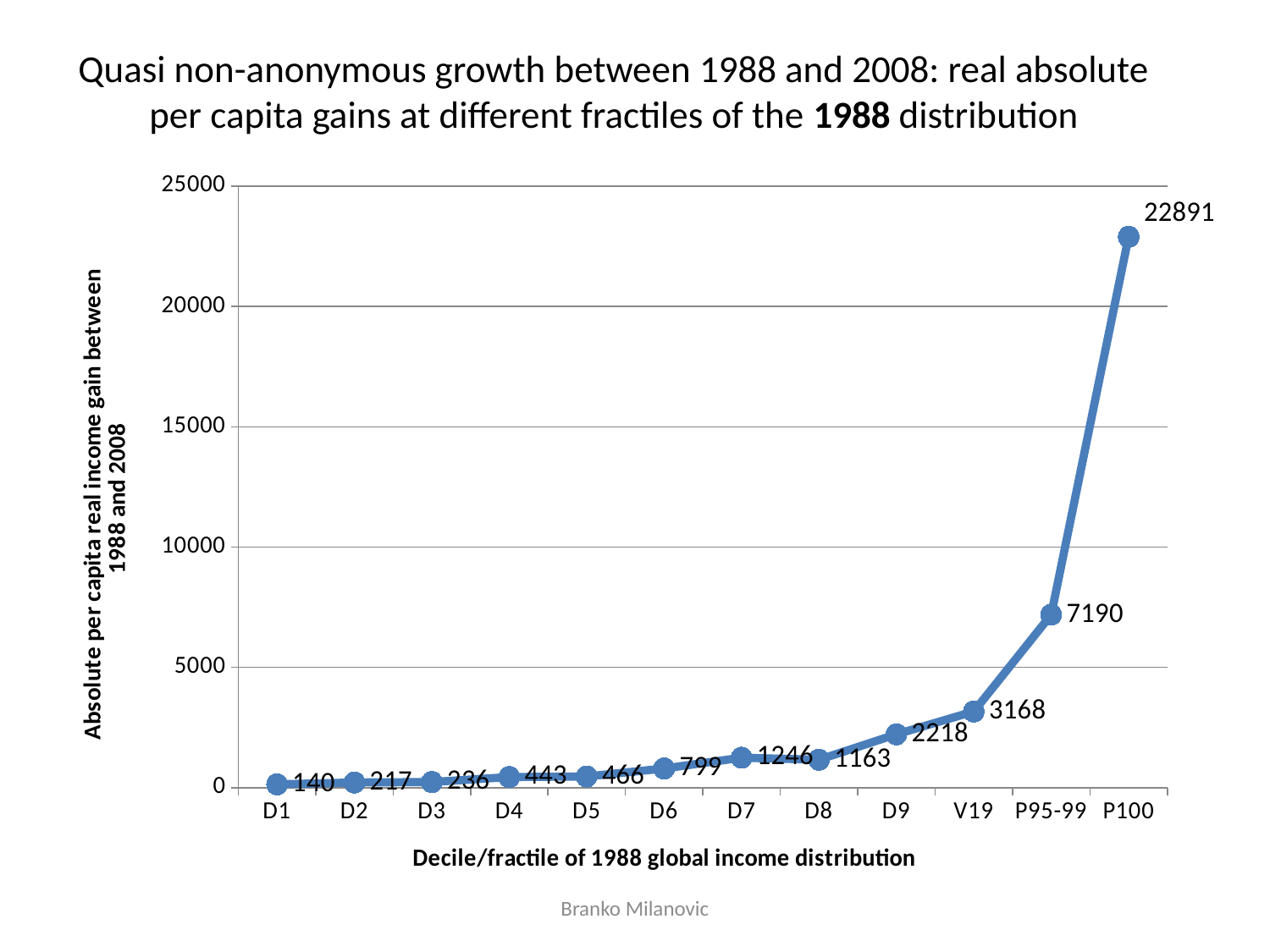
Which fractile has the lowest absolute per capita gain? D1 What is the difference between the values for P100 and P95-99? 15701 What is the title of the x axis? Decile/fractile of 1988 global income distribution Is the value for V19 greater or less than 5000? less How many fractiles are plotted on the x axis? 12 What kind of chart is shown on the slide? line chart What is the absolute per capita real income gain for P100? 22891 What is the value plotted for D1? 140 Which fractile has the highest absolute per capita gain? P100 What is the value plotted for P95-99? 7190 Which has a larger value, D7 or D8? D7 What is the value plotted for D7? 1246